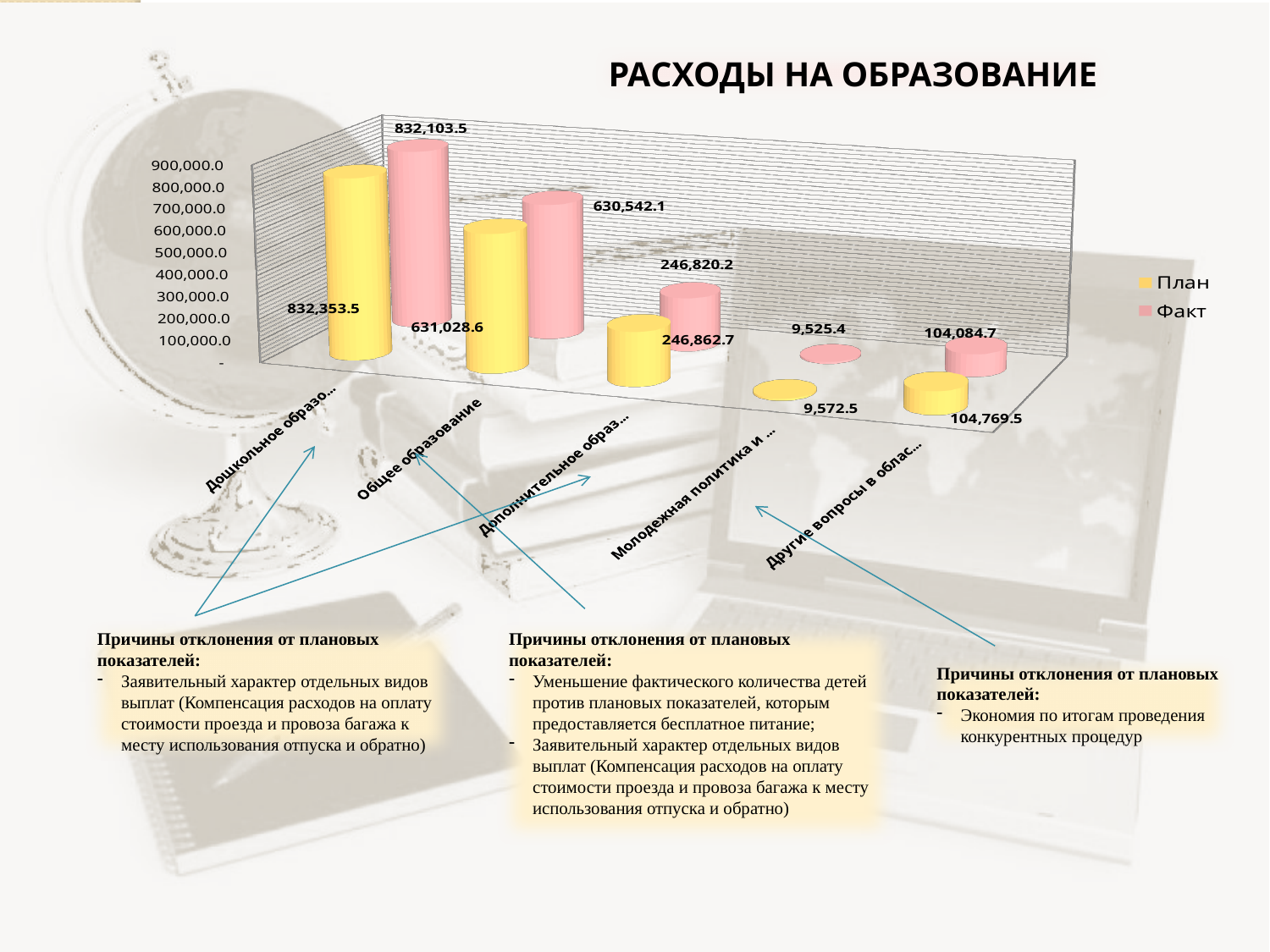
What type of chart is shown on the slide? bar chart Which category has the highest План value? Дошкольное образо... What is the title of the chart? РАСХОДЫ НА ОБРАЗОВАНИЕ Which is larger for Общее образование: the План value or the Факт value? План Which category has the lowest Факт value? Молодежная политика и ... How many categories are shown on the chart's x axis? 5 What is the Факт value for Общее образование? 630,542.1 What is the Факт value for the first category, Дошкольное образо...? 832,103.5 What is the difference between the План and Факт values for Общее образование? 486.5 How many series does the chart legend list? 2 Which series is shown in yellow in the legend? План What is the План value for Общее образование? 631,028.6